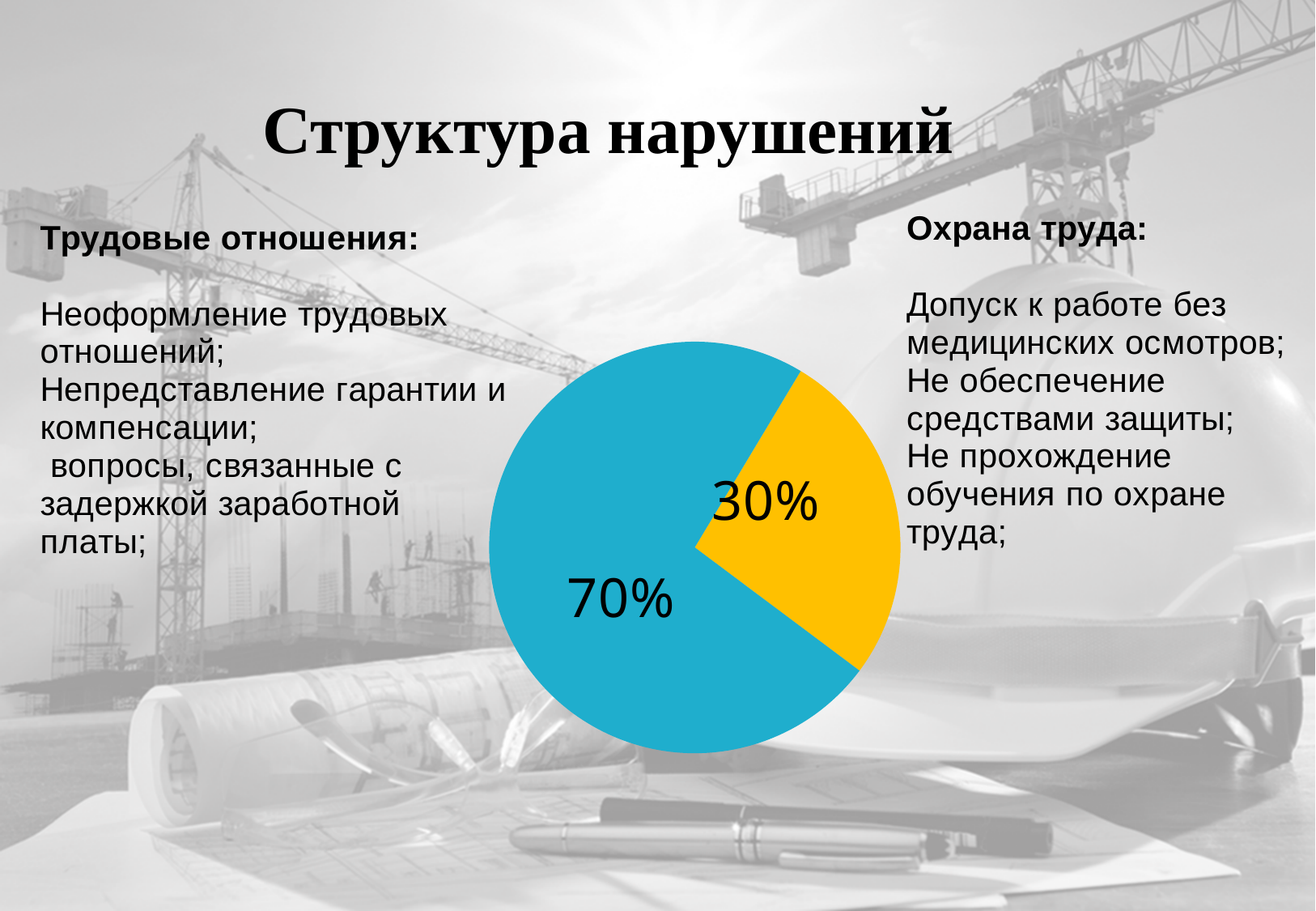
How many slices does the pie chart have? 2 What percentage is shown on the blue slice of the pie chart? 70% What colours are used for the two slices of the pie chart? blue and yellow What is the title of the slide containing the pie chart? Структура нарушений Which is larger, the blue slice or the yellow slice? the blue slice What is the difference in percentage points between the blue slice and the yellow slice? 40 What kind of chart is shown on the slide? pie chart What percentage is shown on the yellow slice of the pie chart? 30% Which slice of the pie chart is the smallest? the yellow slice (30%) Is the value of the yellow slice greater or less than 50%? less Which slice of the pie chart is the largest? the blue slice (70%) What is the total of the two percentages shown on the pie chart? 100%